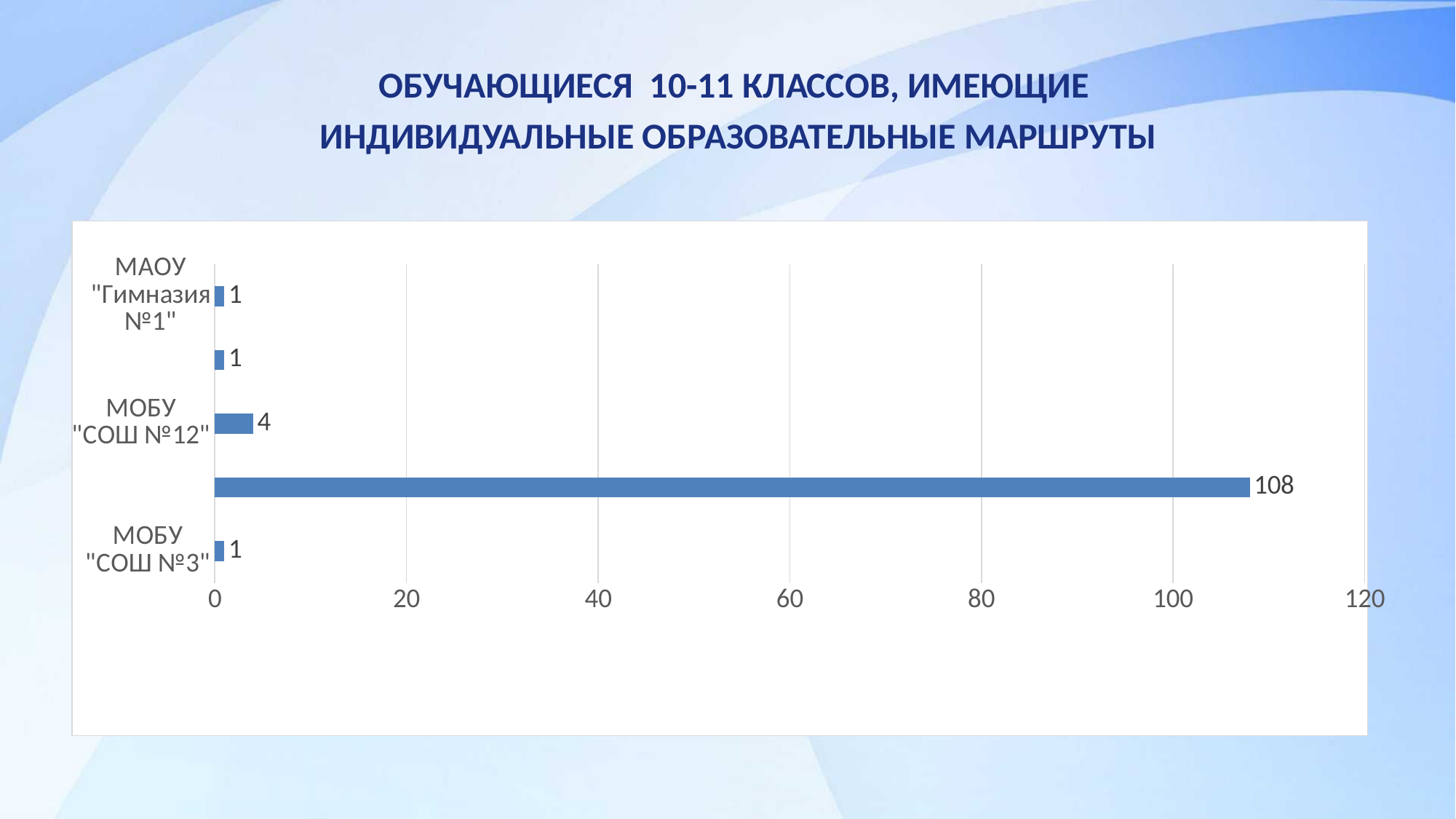
How many bars are plotted on the chart? 5 What is the value for МОБУ "СОШ №12"? 4 What type of chart is shown on the slide? bar chart What is the largest value shown on the chart? 108 What is the difference between the values for МОБУ "СОШ №12" and МАОУ "Гимназия №1"? 3 Is the value for МОБУ "СОШ №12" greater or less than 20? less What is the value for МОБУ "СОШ №3"? 1 What is the value for МАОУ "Гимназия №1"? 1 Which has a larger value, МОБУ "СОШ №12" or МОБУ "СОШ №3"? МОБУ "СОШ №12" Is the value of the longest bar greater or less than 100? greater What is the title of the slide? ОБУЧАЮЩИЕСЯ 10-11 КЛАССОВ, ИМЕЮЩИЕ ИНДИВИДУАЛЬНЫЕ ОБРАЗОВАТЕЛЬНЫЕ МАРШРУТЫ What is the maximum value shown on the horizontal axis? 120